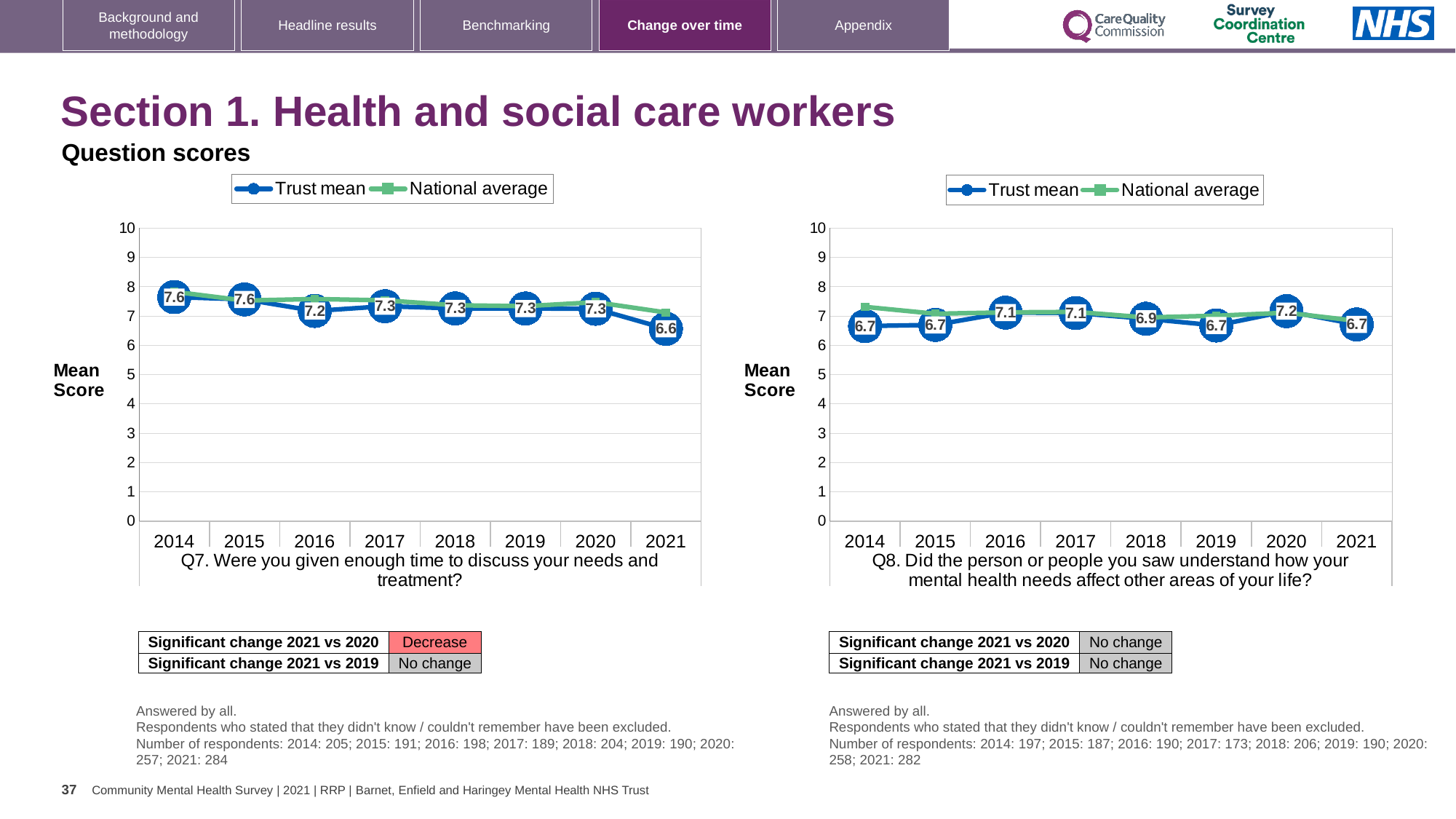
In the Q7 chart (left), how many years are shown on the x axis? 8 In the Q7 chart (left), what is the Trust mean for 2014? 7.6 In the Q8 chart (right), is the Trust mean for 2016 larger or smaller than the Trust mean for 2019? larger In the Q7 chart (left), what is the difference between the Trust mean in 2014 and in 2021? 1.0 In the Q7 chart (left), what is the Trust mean for 2021? 6.6 What type of chart is the Q7 chart on the left? Line chart In the Q8 chart (right), what is the Trust mean for 2020? 7.2 In the Q8 chart (right), what is the Trust mean for 2018? 6.9 In the Q8 chart (right), how many series does the legend list? 2 In the Q7 chart (left), which year has the lowest Trust mean? 2021 In the Q7 chart (left), does the Trust mean rise or fall from 2020 to 2021? fall In the Q8 chart (right), which year has the highest Trust mean? 2020